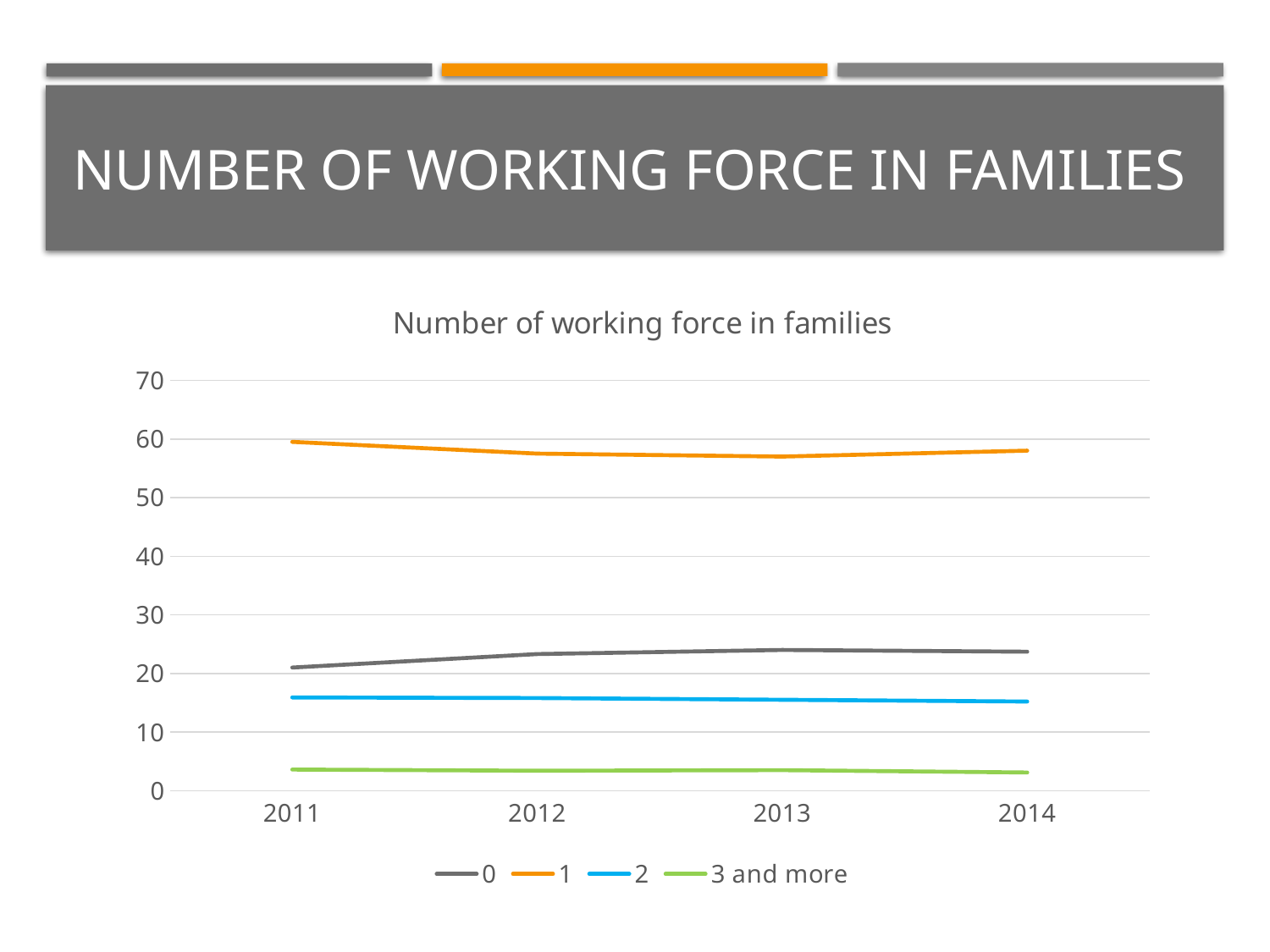
Which series has the lowest values across all years? 3 and more What is the title of the chart? Number of working force in families Is the value for series 3 and more in 2013 greater or less than 10? less Which is larger in 2012, the value for series 0 or the value for series 2? 0 Which series has the highest values across all years? 1 Is the value for series 2 in 2014 greater or less than 10? greater How many years are shown on the x axis? 4 Is the value for series 0 in 2011 greater or less than 30? less Does the line for series 0 rise or fall from 2011 to 2013? rise What kind of chart is shown on the slide? line chart How many series does the legend list? 4